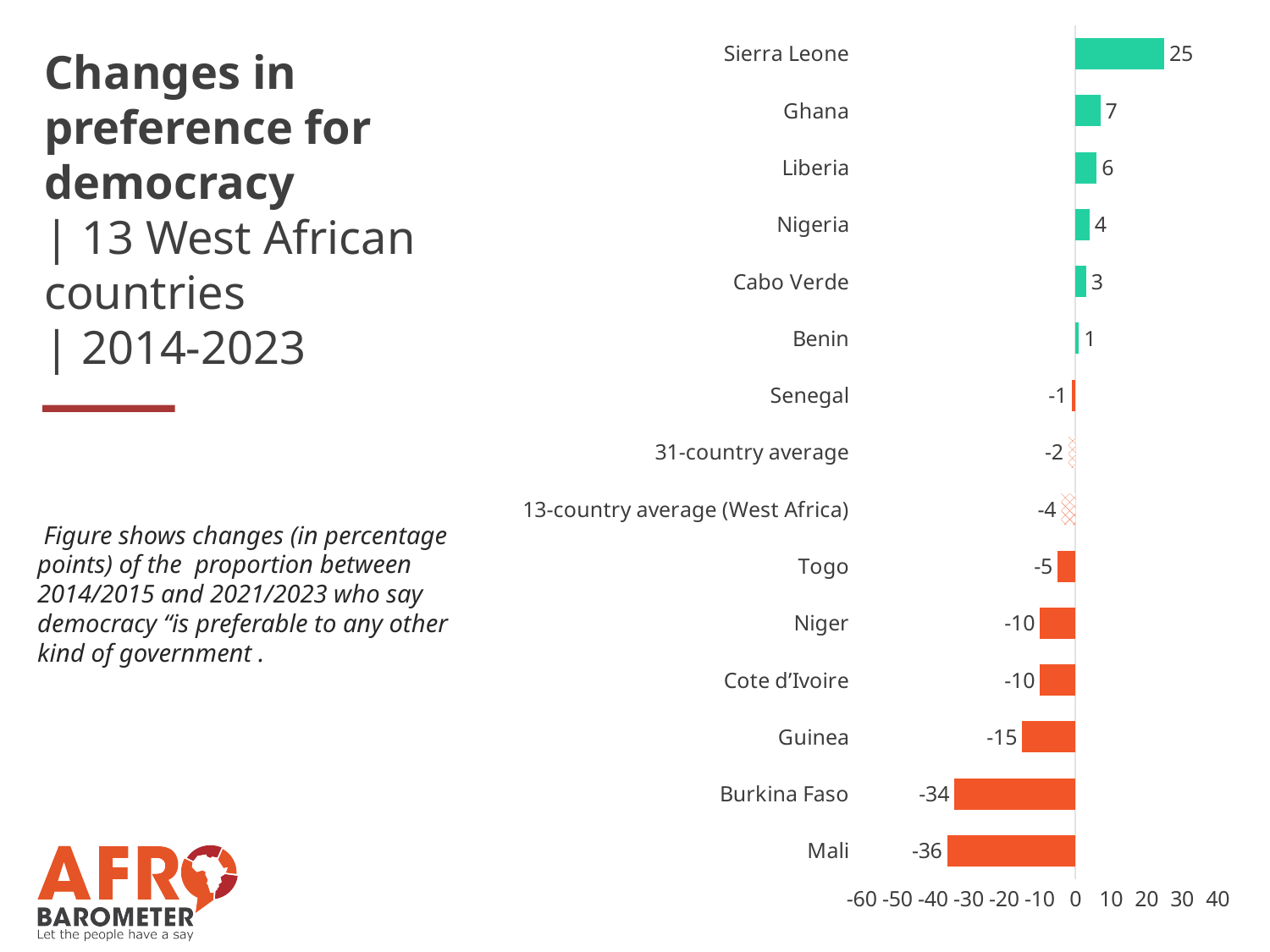
Which category has the highest value? Sierra Leone What is the value for the 13-country average (West Africa)? -4 What is the value for Sierra Leone? 25 What kind of chart is shown on the slide? Bar chart What is the difference between the values for Burkina Faso and Mali? 2 How many categories are shown in the chart? 15 What is the value for Mali? -36 Which category has the lowest value? Mali Which is larger, the value for Liberia or the value for Nigeria? Liberia What is the value for the 31-country average? -2 What is the value for Guinea? -15 What is the difference between the values for Sierra Leone and Ghana? 18